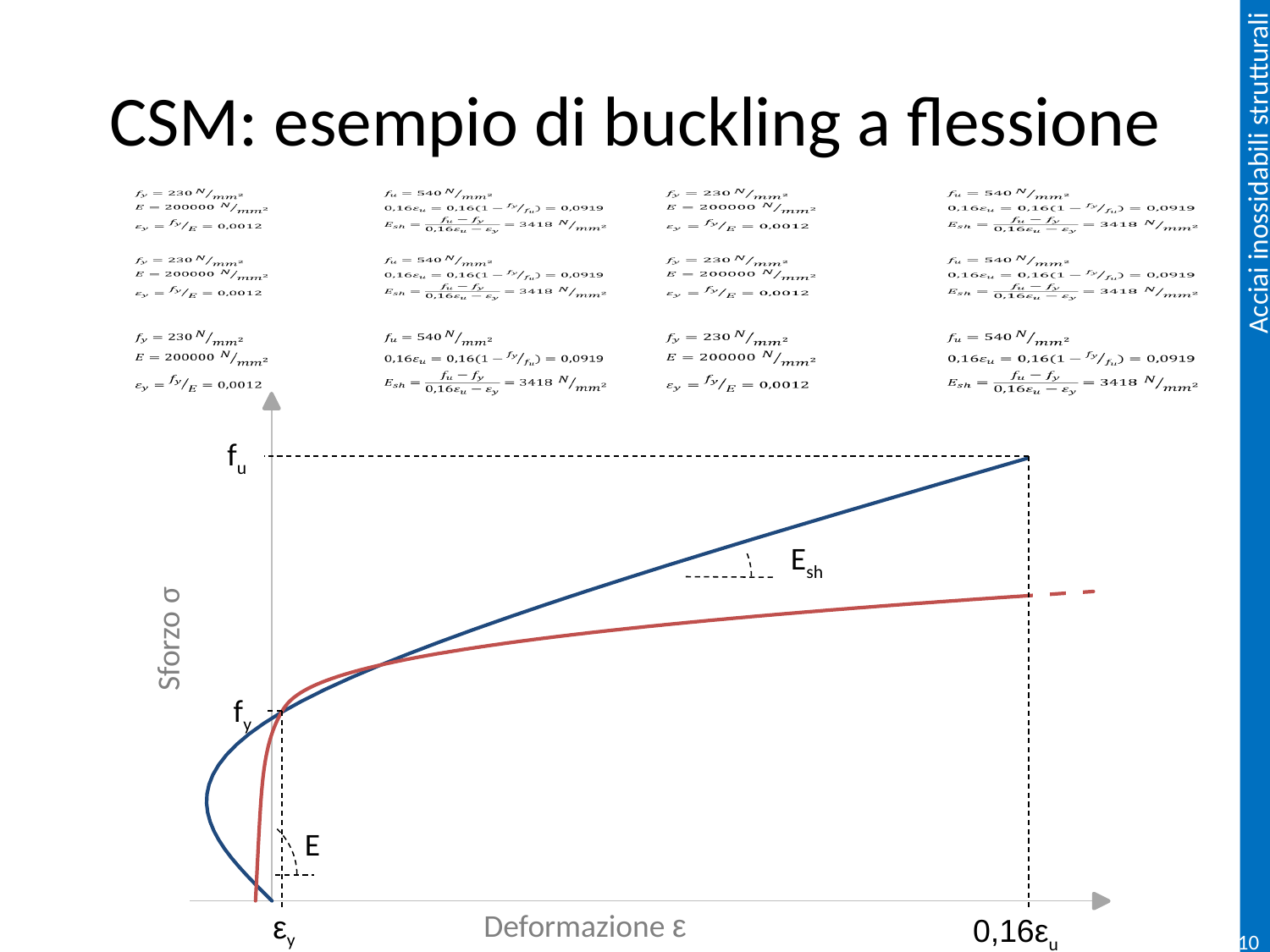
Which strain value is marked on the horizontal axis at the point where the stress reaches f_y? ε_y According to the formulas on the slide, what is the value of E_sh? 3418 N/mm² What is the label of the horizontal axis of the chart? Deformazione ε Which strain value is marked at the far right of the horizontal axis? 0,16ε_u According to the formulas on the slide, what is the value of f_u? 540 N/mm² What is the label of the vertical axis of the chart? Sforzo σ According to the formulas on the slide, what is the value of f_y? 230 N/mm² Which stress level is marked by the dashed line at the top of the vertical axis? f_u How many curves are plotted on the chart? 2 What kind of chart is shown on the slide? line chart At the strain 0,16ε_u, which curve reaches the higher stress, the blue one or the red one? blue Does the blue curve rise or fall as the strain increases beyond ε_y? rise